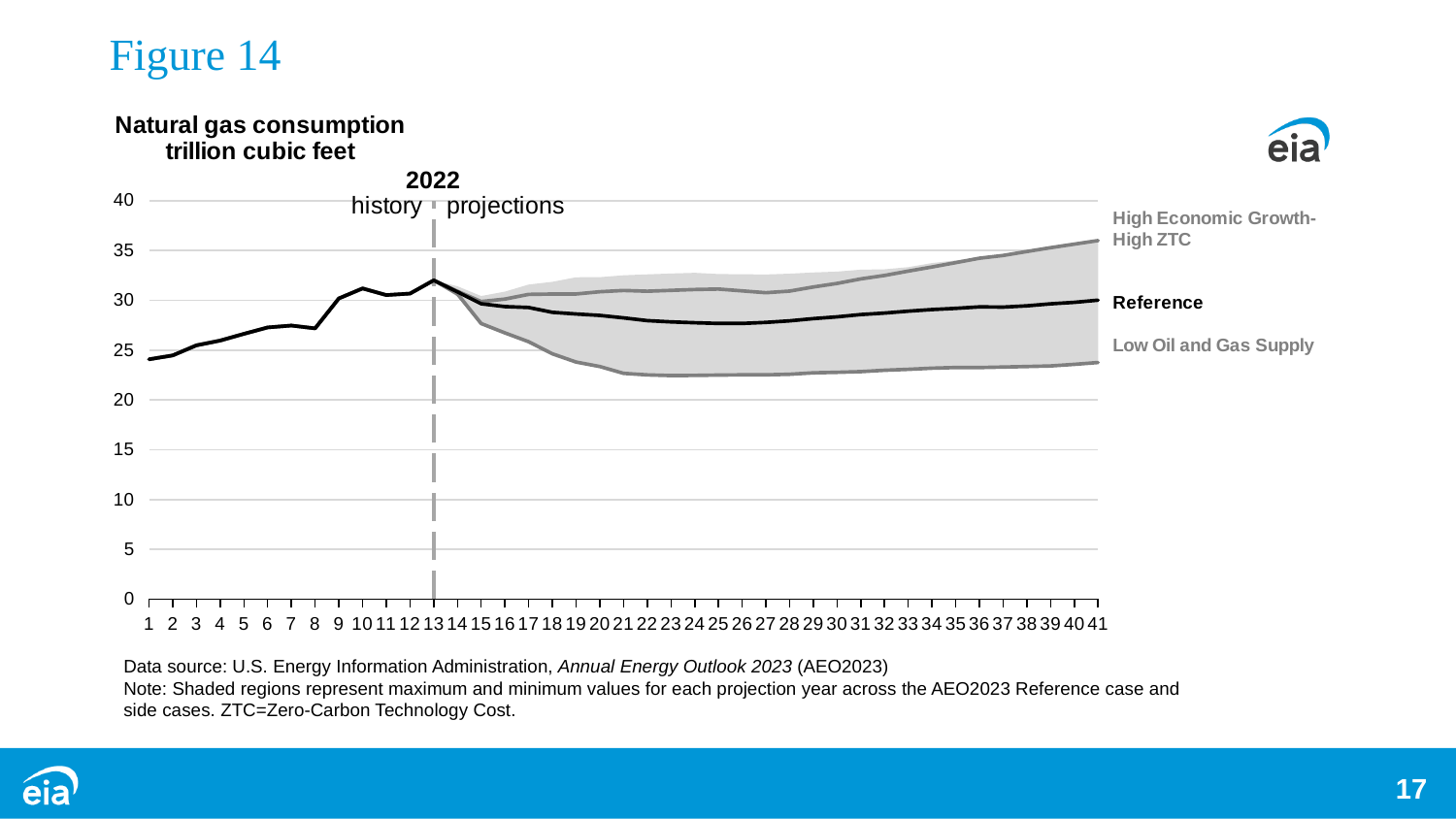
At point 13 (the 2022 line), is the value of the history line greater or less than 30? greater Which series has the highest value at point 41 on the x axis? High Economic Growth-High ZTC Does the history line generally rise or fall from point 1 to point 13? rise How many named series (cases) are labeled on the chart? 3 At point 41, is the value for the Low Oil and Gas Supply case greater or less than 25? less At point 41, is the value for the Reference case greater or less than 25? greater What unit of measurement is given under the chart title? trillion cubic feet How many points are labeled along the x axis of the chart? 41 At point 41, which is larger: the High Economic Growth-High ZTC value or the Low Oil and Gas Supply value? High Economic Growth-High ZTC Which series has the lowest value at point 41 on the x axis? Low Oil and Gas Supply What kind of chart is shown on the slide? combination area and line chart (lines with a shaded band)